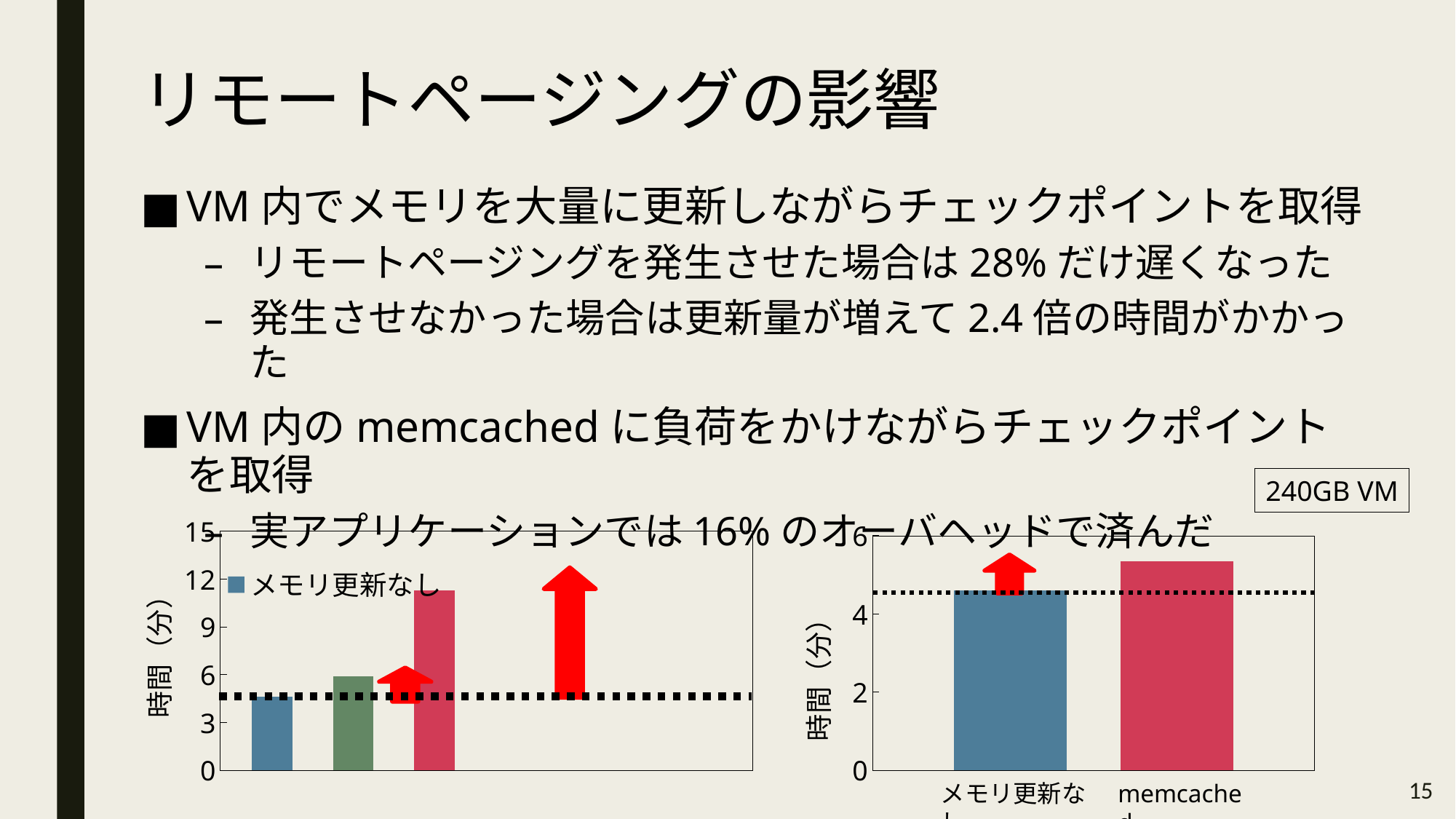
In the chart on the right of the slide, which category has the higher value, メモリ更新なし or memcached? memcached In the chart on the right of the slide, is the value for memcached greater or less than 4? greater In the chart on the right of the slide, which category has the lowest value? メモリ更新なし In the chart on the right of the slide, is the value for memcached greater or less than 6? less How many bars are plotted in the chart on the right of the slide? 2 How many bars are plotted in the chart on the left of the slide? 3 What VM size is noted in the box above the chart on the right of the slide? 240GB VM What is the y-axis label of the chart on the right of the slide? 時間（分） What kind of chart is the chart on the left of the slide? bar chart In the chart on the left of the slide, is the value of the first (blue) bar greater or less than 6? less What kind of chart is the chart on the right of the slide? bar chart